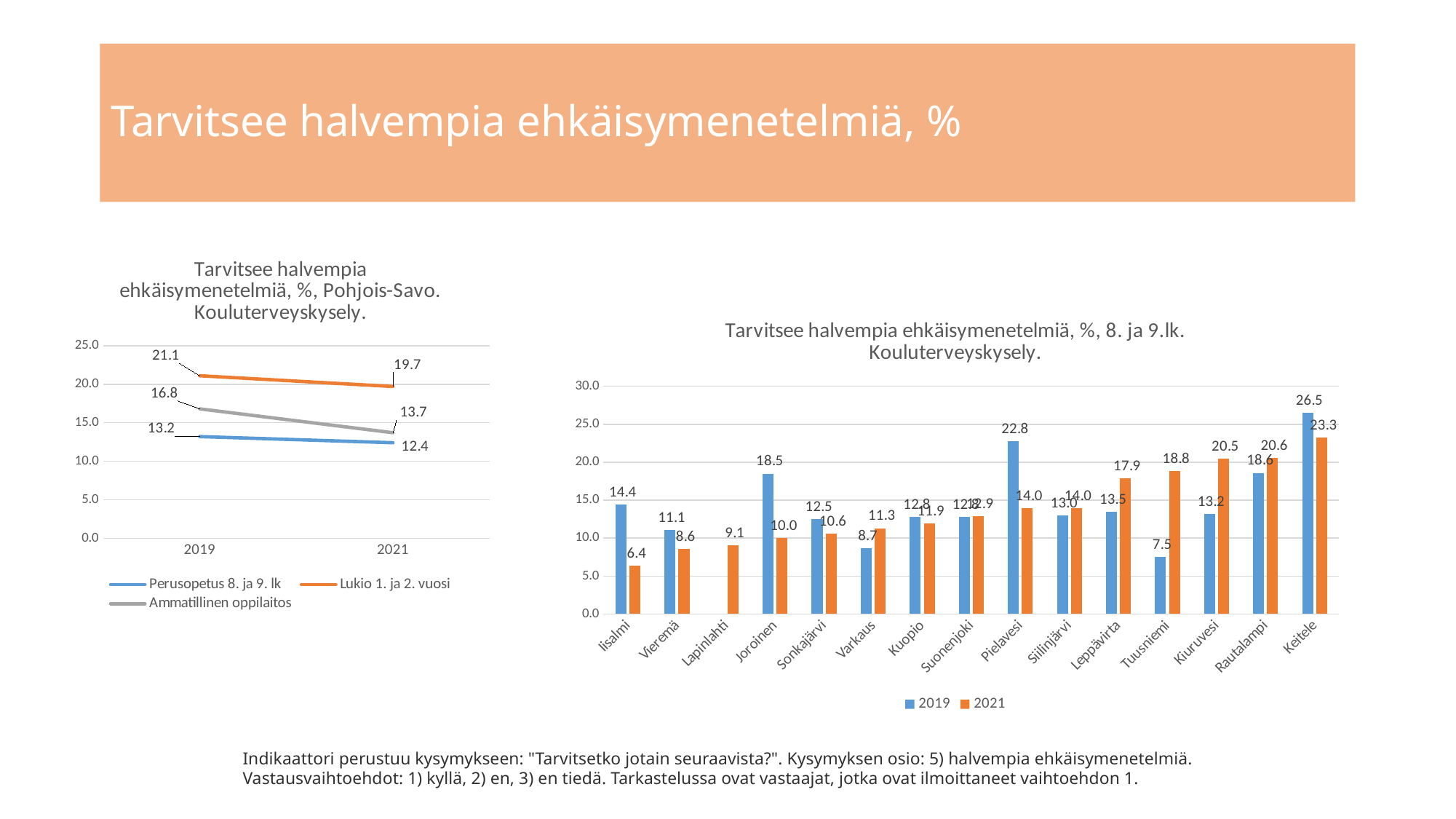
What kind of chart is the left chart (Pohjois-Savo)? line chart In the left chart (Pohjois-Savo), what is the value for Ammatillinen oppilaitos in 2021? 13.7 In the right chart (8. ja 9.lk), what is the 2021 value for Tuusniemi? 18.8 In the left chart (Pohjois-Savo), how many series does the legend list? 3 In the left chart (Pohjois-Savo), does the Perusopetus 8. ja 9. lk series rise or fall from 2019 to 2021? fall In the right chart (8. ja 9.lk), how many municipalities are shown on the x axis? 15 In the right chart (8. ja 9.lk), which is larger for Kiuruvesi, the 2019 value or the 2021 value? 2021 In the right chart (8. ja 9.lk), which municipality has the lowest 2021 value? Iisalmi In the right chart (8. ja 9.lk), which municipality has the highest 2019 value? Keitele In the left chart (Pohjois-Savo), what is the difference between the Lukio 1. ja 2. vuosi values in 2019 and 2021? 1.4 In the right chart (8. ja 9.lk), what is the 2019 value for Pielavesi? 22.8 In the left chart (Pohjois-Savo), what is the value for Lukio 1. ja 2. vuosi in 2019? 21.1